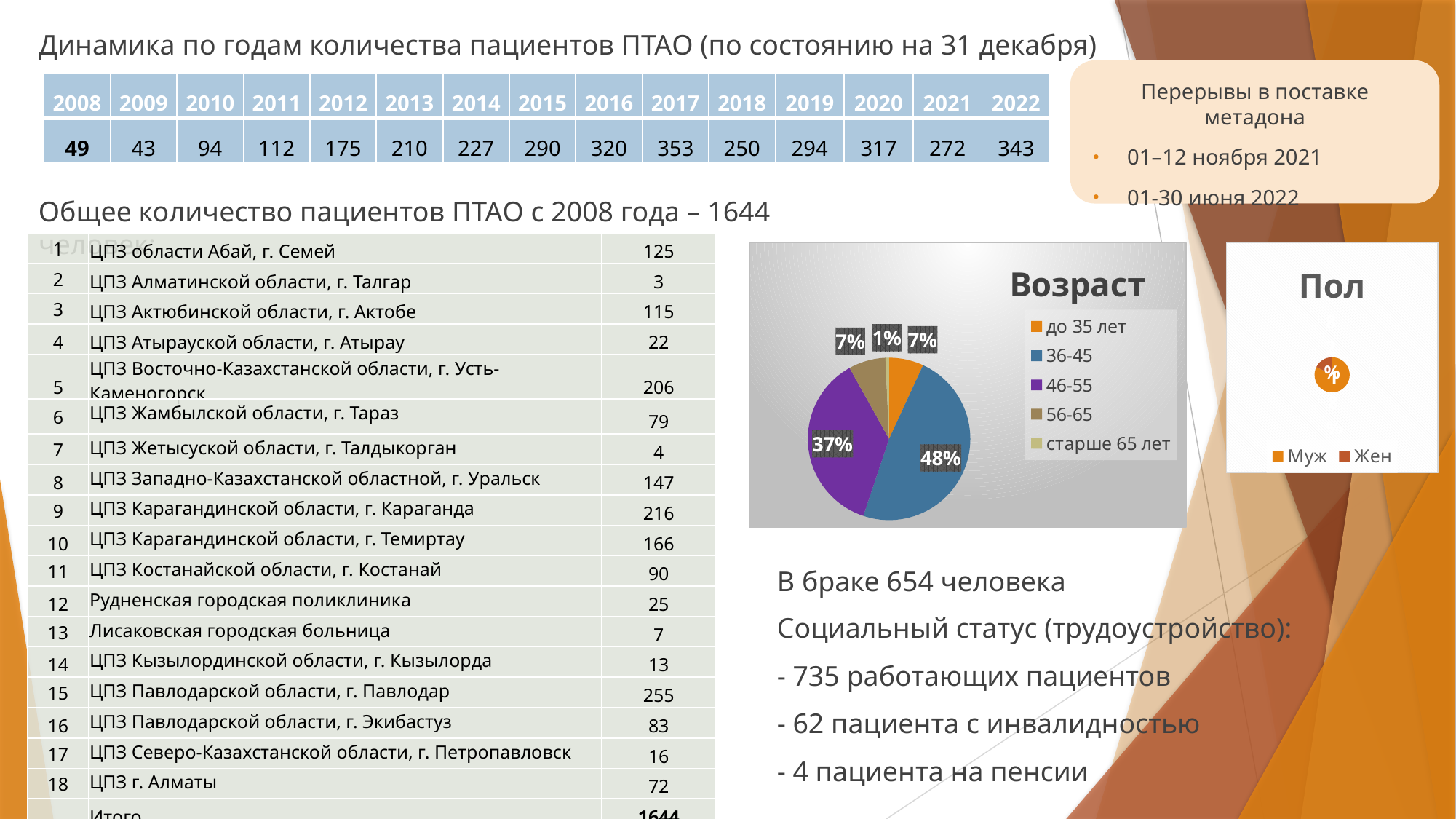
In the "Возраст" pie chart, what share is shown for the "до 35 лет" group? 7% In the "Возраст" pie chart, which age group has the smallest share? старше 65 лет What are the legend entries of the "Пол" chart? Муж, Жен In the "Возраст" pie chart, what is the difference in percentage points between the 36-45 and 46-55 groups? 11 What kind of chart is the "Возраст" chart? pie chart In the "Возраст" pie chart, what share is shown for the "старше 65 лет" group? 1% In the "Возраст" pie chart, which age group has the largest share? 36-45 In the "Возраст" pie chart, what share is shown for the 36-45 age group? 48% In the "Возраст" pie chart, which group has the larger share: 46-55 or 56-65? 46-55 How many age groups are listed in the legend of the "Возраст" chart? 5 In the "Возраст" pie chart, what share is shown for the 46-55 age group? 37% How many entries does the legend of the "Пол" chart list? 2